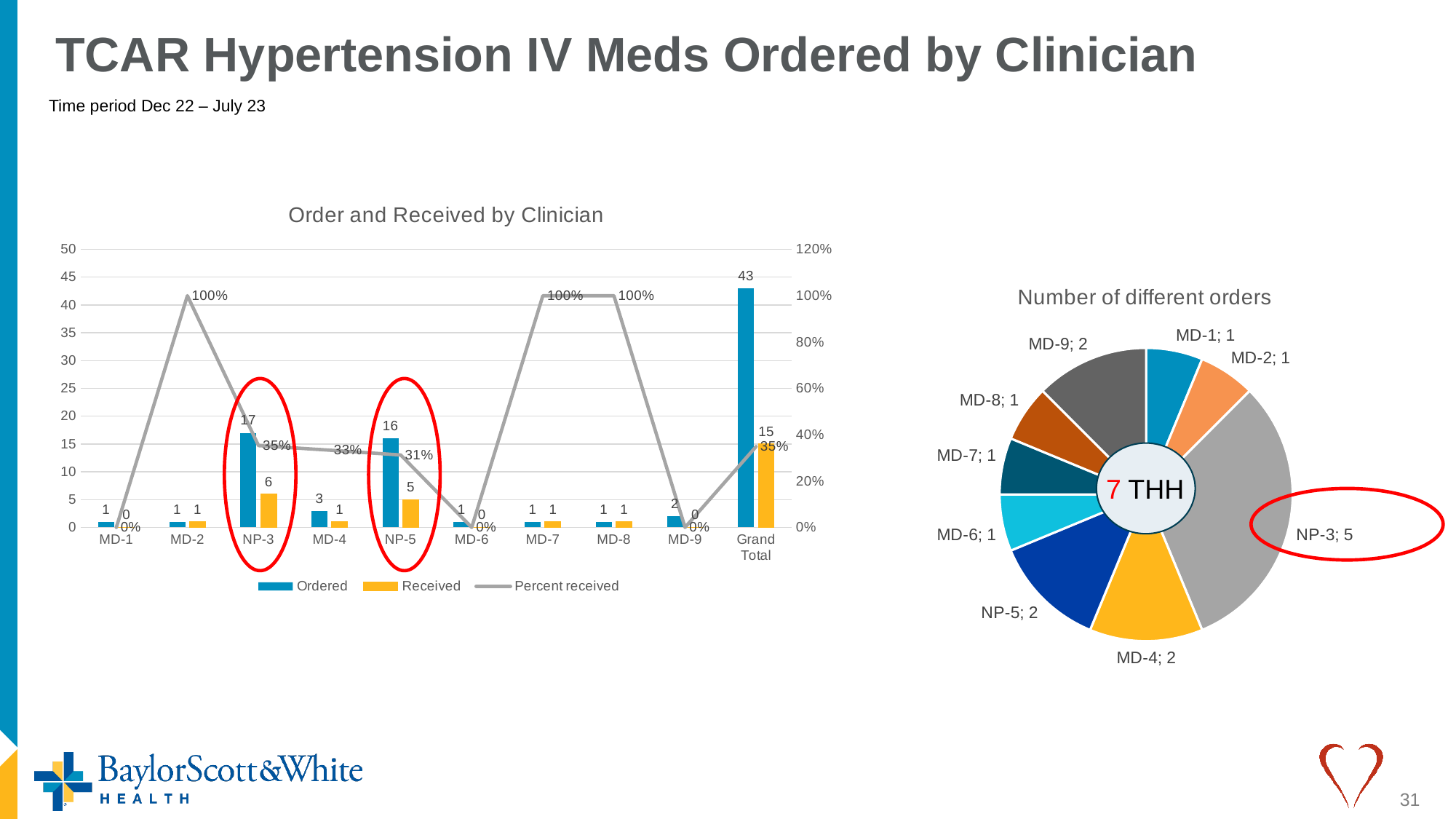
In the 'Order and Received by Clinician' chart, what is the Percent received for the Grand Total? 35% In the 'Order and Received by Clinician' chart, excluding the Grand Total, which clinician has the highest Ordered value? NP-3 How many slices does the 'Number of different orders' pie chart have? 9 In the 'Number of different orders' pie chart, which clinician has the largest slice? NP-3 In the 'Order and Received by Clinician' chart, which is larger, the Ordered value for NP-3 or the Ordered value for NP-5? NP-3 In the 'Order and Received by Clinician' chart, how many IV meds were ordered by NP-3? 17 How many categories are shown on the x axis of the 'Order and Received by Clinician' chart? 10 What type of chart is the 'Number of different orders' chart? Pie chart In the 'Order and Received by Clinician' chart, what is the Received value for NP-5? 5 How many series does the legend of the 'Order and Received by Clinician' chart list? 3 In the 'Number of different orders' pie chart, what is the value for NP-3? 5 In the 'Order and Received by Clinician' chart, what is the difference between the Ordered and Received values for the Grand Total? 28